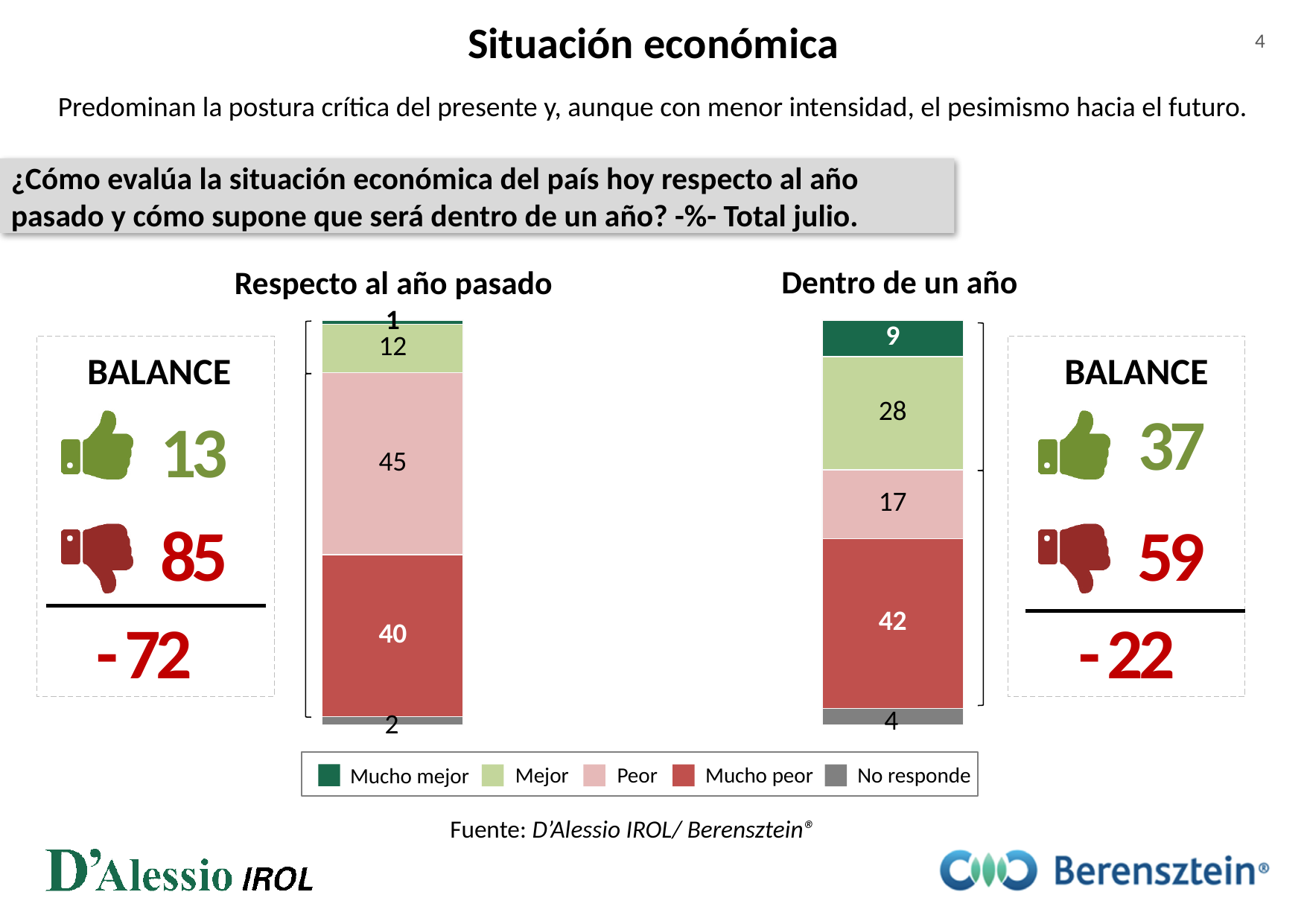
What is the BALANCE figure shown next to the 'Dentro de un año' bar? -22 How many series does the legend list? 5 What is the difference between the 'Mejor' values in the 'Dentro de un año' bar and the 'Respecto al año pasado' bar? 16 In the 'Respecto al año pasado' bar, what is the value for 'Peor'? 45 Which is larger: 'Peor' in 'Respecto al año pasado' or 'Peor' in 'Dentro de un año'? Respecto al año pasado What kind of chart is shown on the slide? Stacked bar chart In the 'Dentro de un año' bar, which category has the lowest value? No responde In the 'Dentro de un año' bar, what is the value for 'Mucho peor'? 42 What is the total of the 'Dentro de un año' stacked bar? 100 In the 'Respecto al año pasado' bar, what is the value for 'No responde'? 2 In the 'Dentro de un año' bar, what is the value for 'Mucho mejor'? 9 In the 'Respecto al año pasado' bar, which category has the highest value? Peor